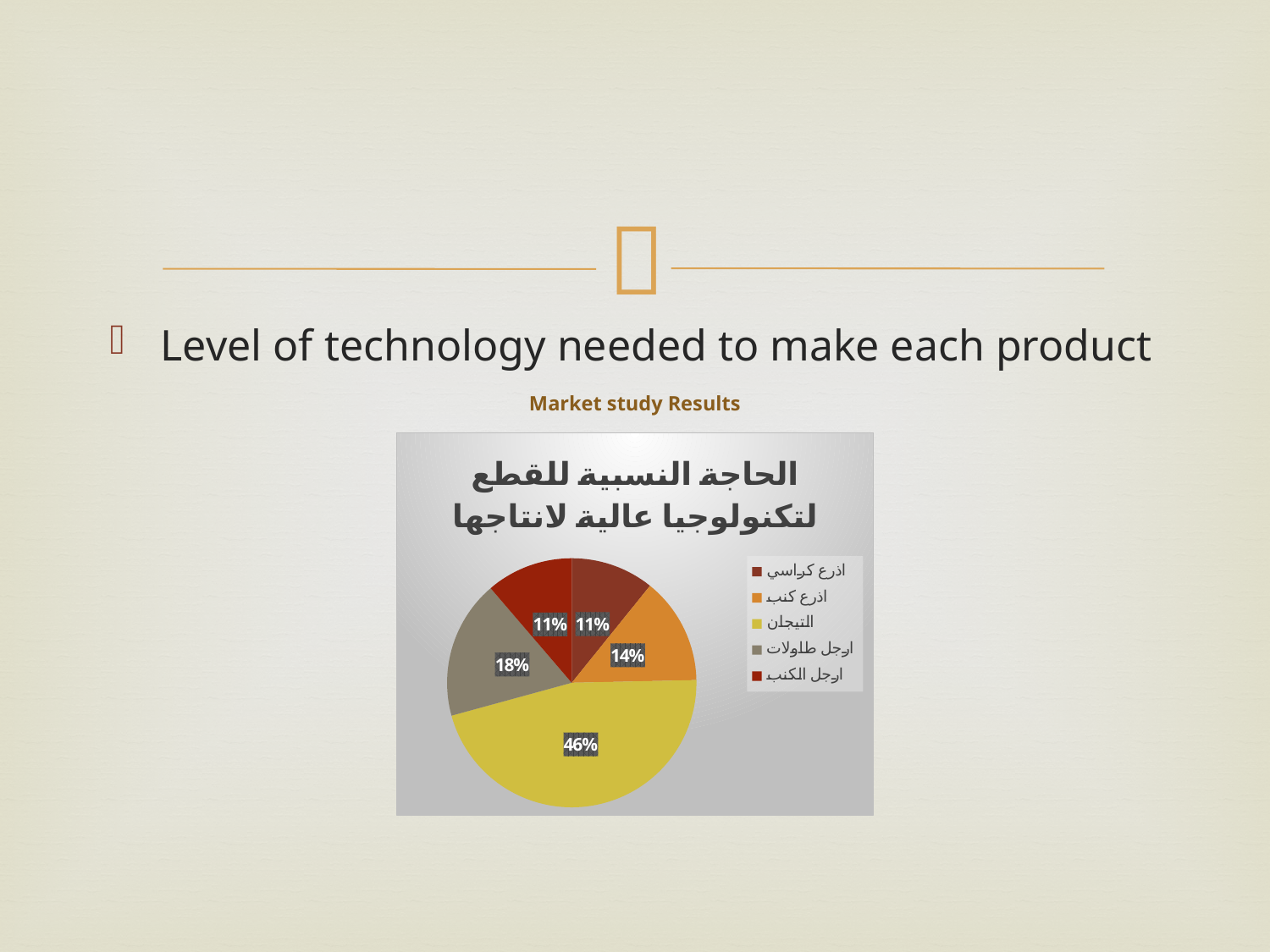
What share of the pie does اذرع كنب (the orange slice) take? 14% Which category has the largest slice of the pie? التيجان What share of the pie does ارجل طاولات (the grey slice) take? 18% How many slices does the pie chart have? 5 What is the difference in percentage points between the التيجان slice and the ارجل طاولات slice? 28 What is the heading printed directly above the chart on the slide? Market study Results What share of the pie does اذرع كراسي (the dark brown slice) take? 11% What kind of chart is shown on the slide? Pie chart Which slice is larger, اذرع كنب or ارجل طاولات? ارجل طاولات How many entries does the legend of the pie chart list? 5 What is the combined share of the two slices labelled 11%? 22%